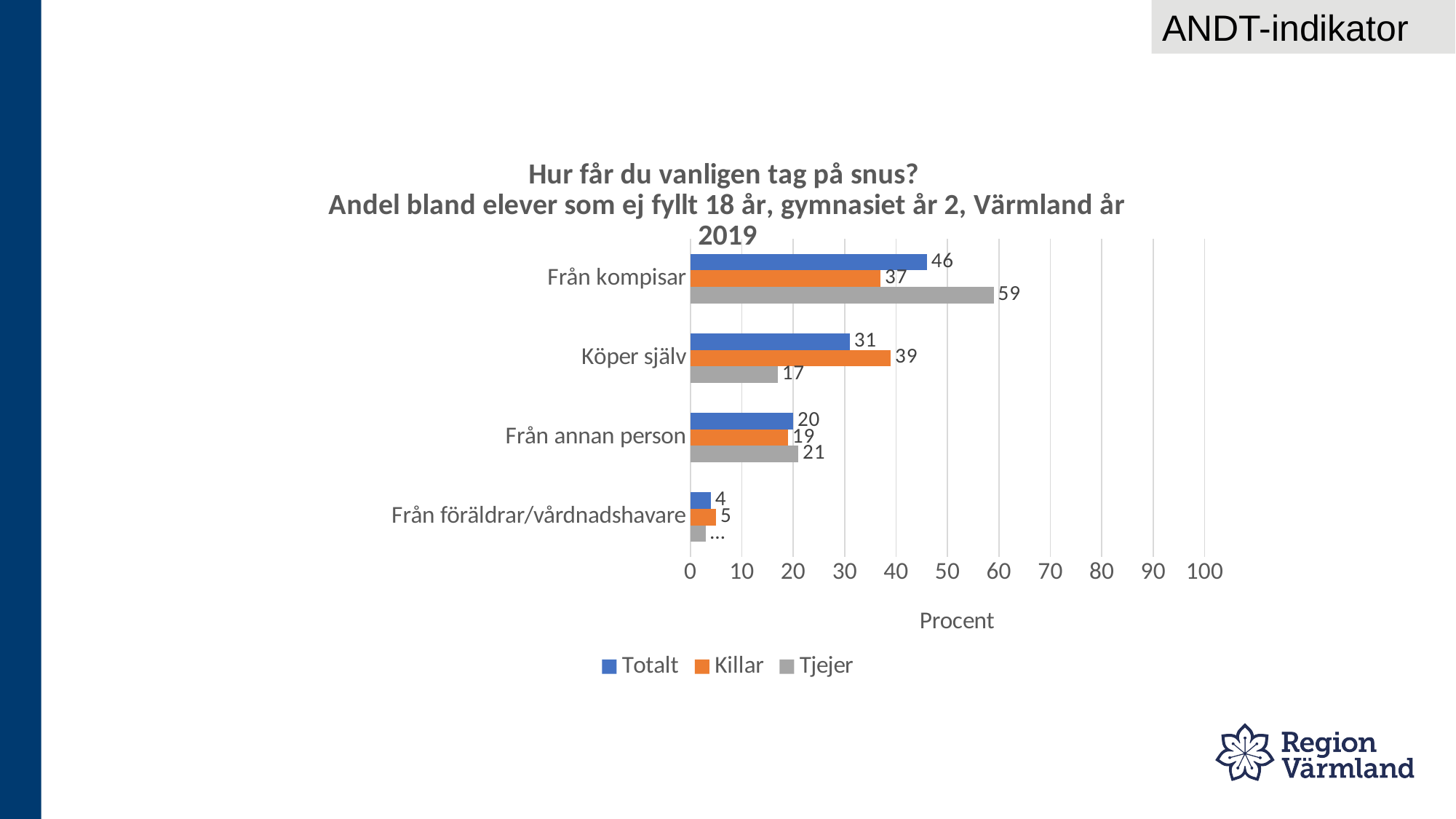
Is the value for Tjejer in the category Från kompisar greater or less than 50? greater What is the difference between the Tjejer and Killar values in the category Från kompisar? 22 What is the value for Killar in the category Köper själv? 39 Which category has the lowest value for the Tjejer series? Från föräldrar/vårdnadshavare In the category Köper själv, which is larger: the value for Killar or the value for Tjejer? Killar What kind of chart is shown on the slide? Bar chart What is the value for Totalt in the category Från annan person? 20 How many categories are shown on the chart? 4 How many series does the legend list? 3 Which category has the highest value for the Totalt series? Från kompisar What is the value for Tjejer in the category Från kompisar? 59 What is the value for Killar in the category Från föräldrar/vårdnadshavare? 5